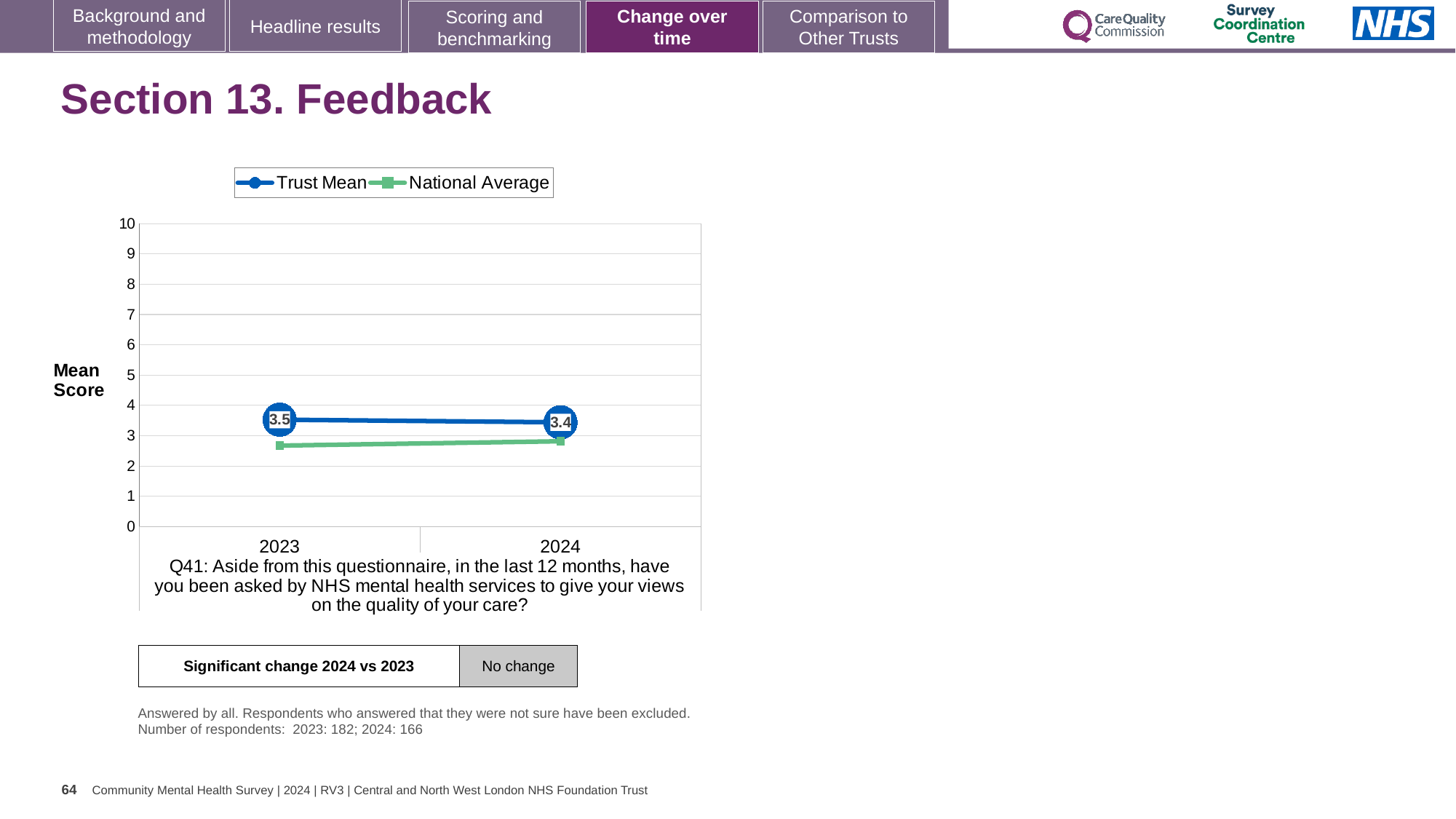
Is the Trust Mean value for 2024 greater or less than 5? less Which year has the higher Trust Mean, 2023 or 2024? 2023 Is the National Average value for 2023 greater or less than 3? less What is the Trust Mean score for 2024? 3.4 What kind of chart is shown on the slide? Line chart How many years are plotted on the x axis? 2 What is the Trust Mean score for 2023? 3.5 How many series does the legend list? 2 What is the label on the y axis of the chart? Mean Score By how much did the Trust Mean change between 2023 and 2024? 0.1 In 2023, which series is higher: Trust Mean or National Average? Trust Mean Does the Trust Mean rise or fall from 2023 to 2024? Fall